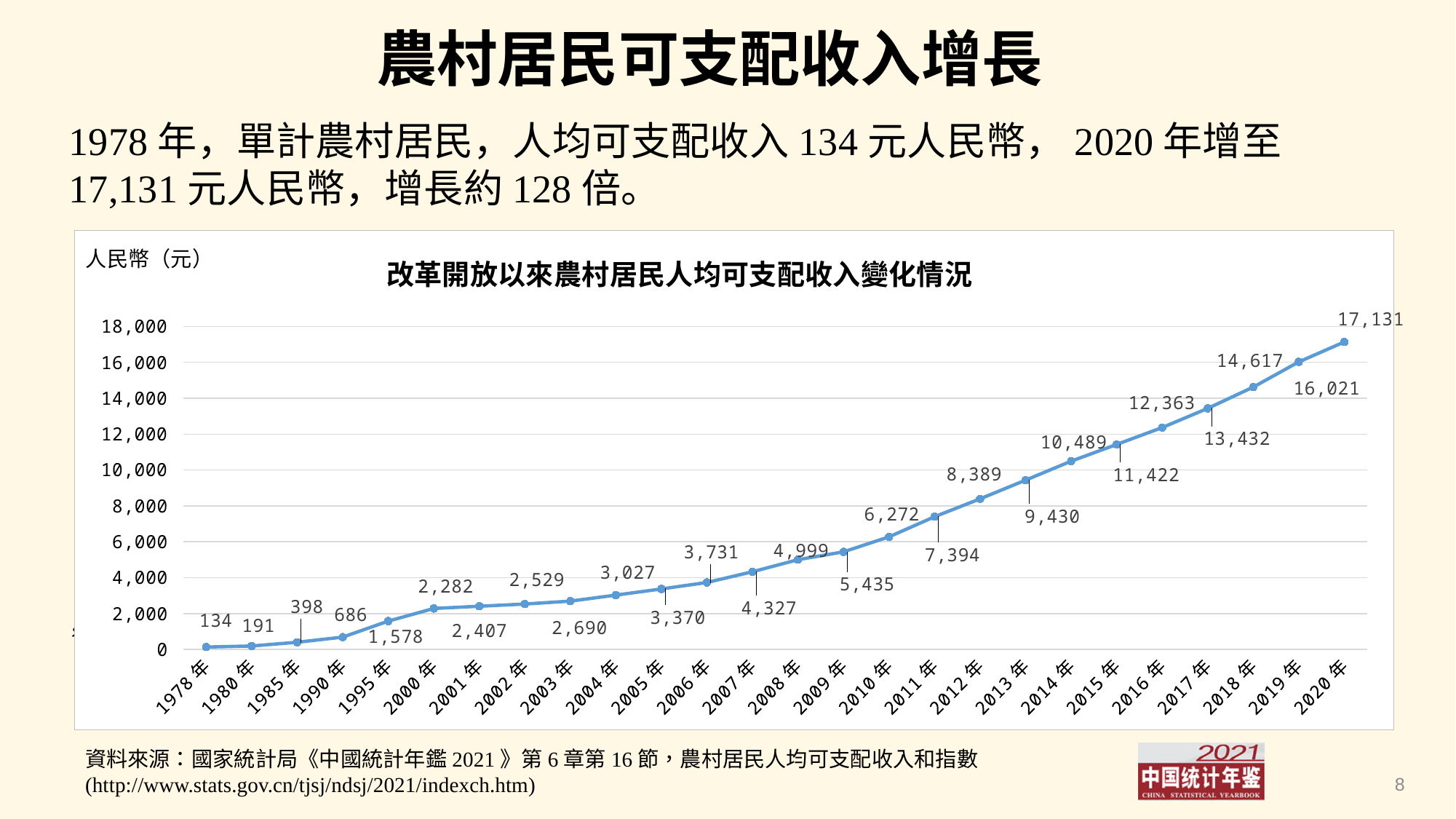
Which year has the lowest value? 1978年 What is the value for 1995年? 1,578 Which is larger, the value for 2008年 or the value for 2009年? 2009年 What is the value for 2010年? 6,272 What kind of chart is this? line chart How many years are plotted on the x axis? 26 What is the difference between the values for 2020年 and 2019年? 1,110 Do the values rise or fall from 1978年 to 2020年? rise What is the difference between the values for 2000年 and 1995年? 704 What is the value for 2017年? 13,432 Is the value for 2014年 greater or less than 10,000? greater Which year has the highest value? 2020年